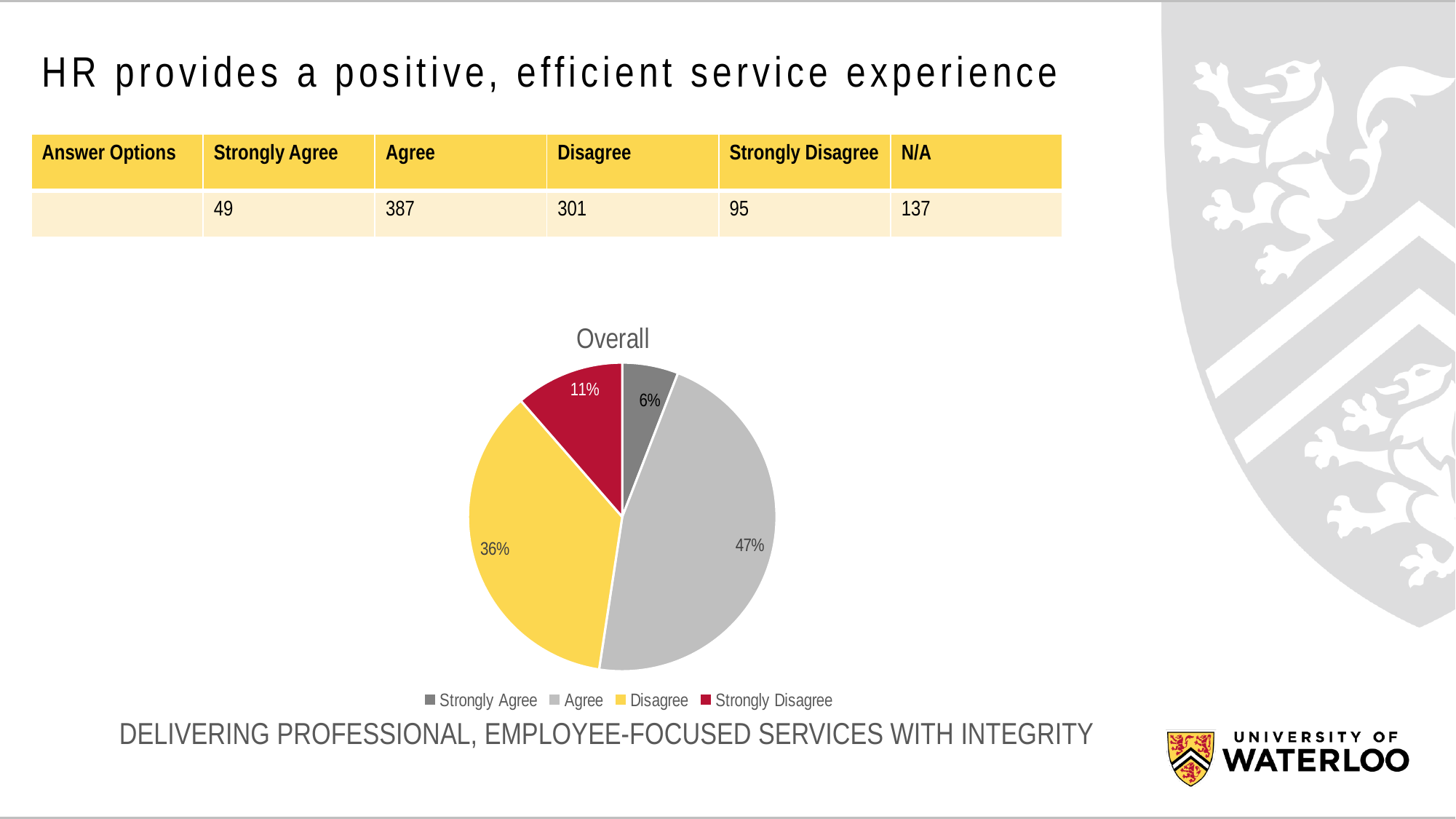
What type of chart is shown on the slide? pie chart What share of the pie does Agree represent? 47% How many entries does the legend list? 4 Which category has the smallest slice of the pie? Strongly Agree What share of the pie does Strongly Disagree represent? 11% Which slice is larger, Strongly Disagree or Strongly Agree? Strongly Disagree What is the title of the chart? Overall How many slices does the pie chart have? 4 What is the difference in percentage points between the Agree and Disagree slices? 11% What share of the pie does Strongly Agree represent? 6% Which category has the largest slice of the pie? Agree